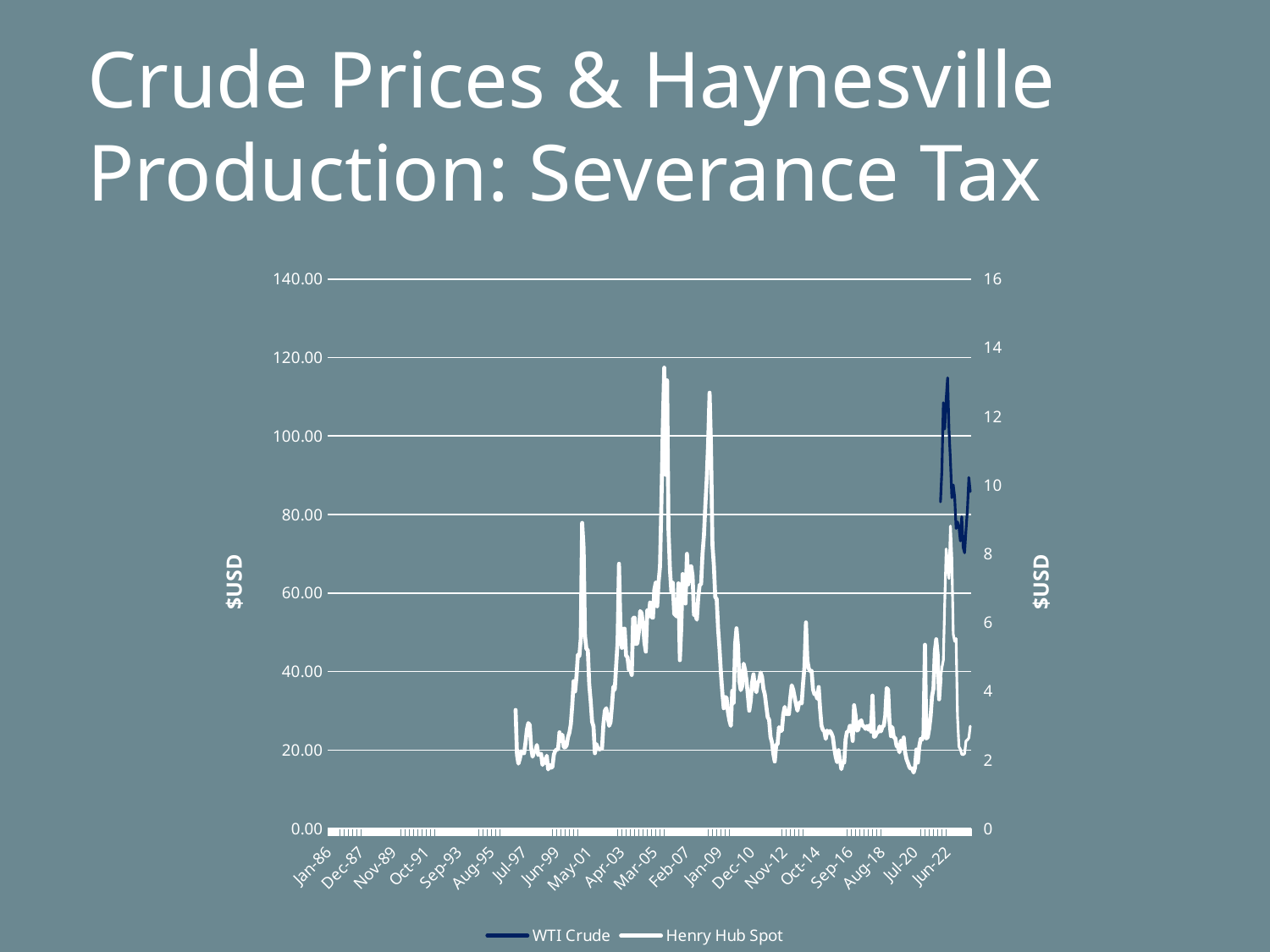
Is the lowest point of the WTI Crude line greater or less than the 60.00 gridline on the left axis? greater Around Jul-20, is the Henry Hub Spot line greater or less than the 40.00 gridline on the left axis? less Is the highest point of the WTI Crude line greater or less than the 100.00 gridline on the left axis? greater Does the Henry Hub Spot line generally rise or fall between Jul-97 and Mar-05? rise How many series does the legend list? 2 How many date labels are shown along the x axis? 20 Does the WTI Crude line rise or fall from its peak to the end of the series? fall Which series is drawn in dark navy? WTI Crude What kind of chart is shown on the slide? line chart What are the two series named in the legend? WTI Crude and Henry Hub Spot